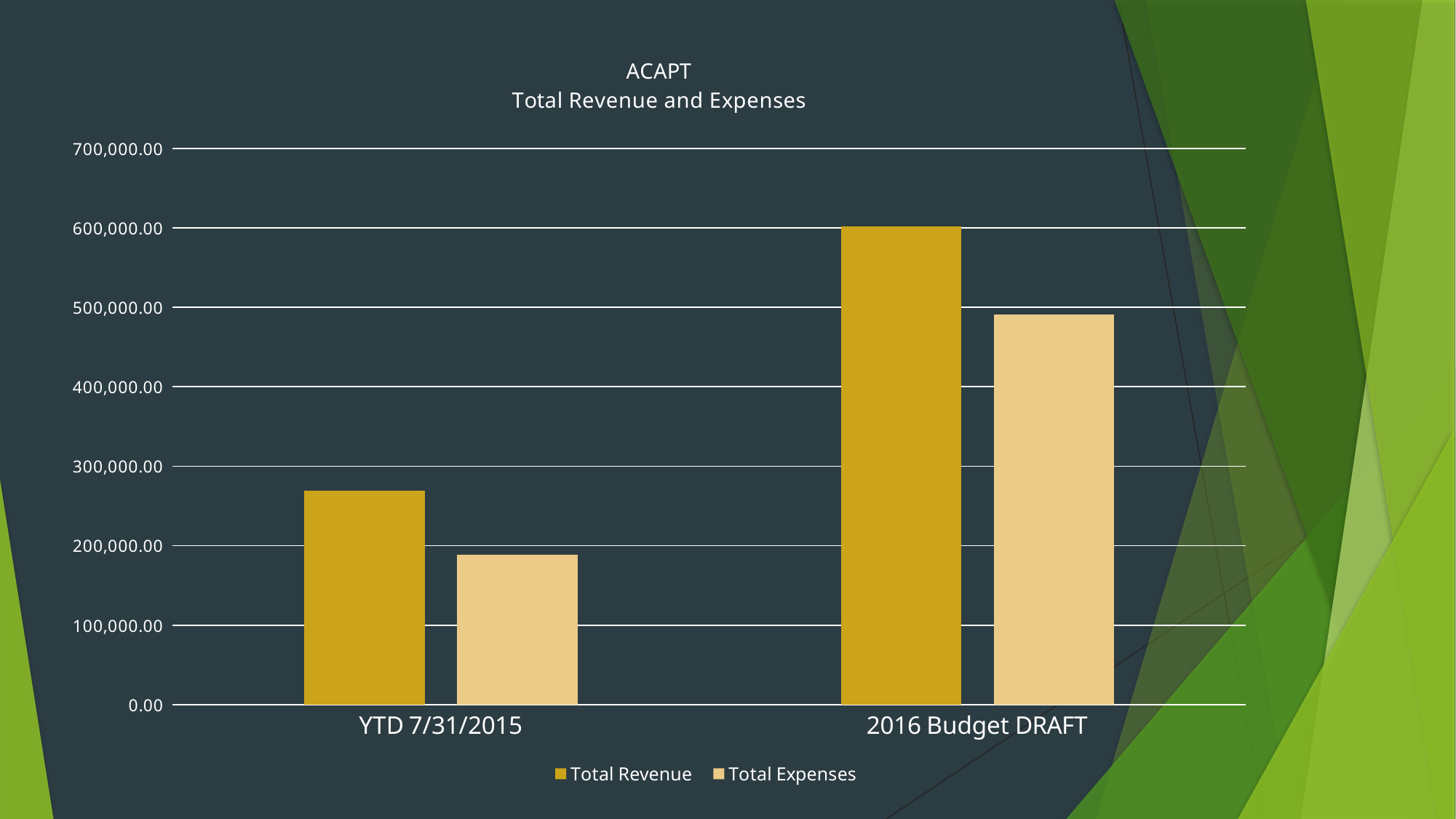
How many categories are shown on the x axis? 2 Does Total Revenue rise or fall from YTD 7/31/2015 to 2016 Budget DRAFT? rise How many series does the legend list? 2 Is the Total Revenue value for YTD 7/31/2015 greater or less than 300,000.00? less For 2016 Budget DRAFT, which is larger, Total Revenue or Total Expenses? Total Revenue Which series and category has the shortest bar? Total Expenses for YTD 7/31/2015 Is the Total Revenue value for 2016 Budget DRAFT greater or less than 500,000.00? greater Is the Total Expenses value for 2016 Budget DRAFT greater or less than 400,000.00? greater What is the title of the chart? ACAPT Total Revenue and Expenses What kind of chart is shown on the slide? bar chart Which series and category has the tallest bar? Total Revenue for 2016 Budget DRAFT